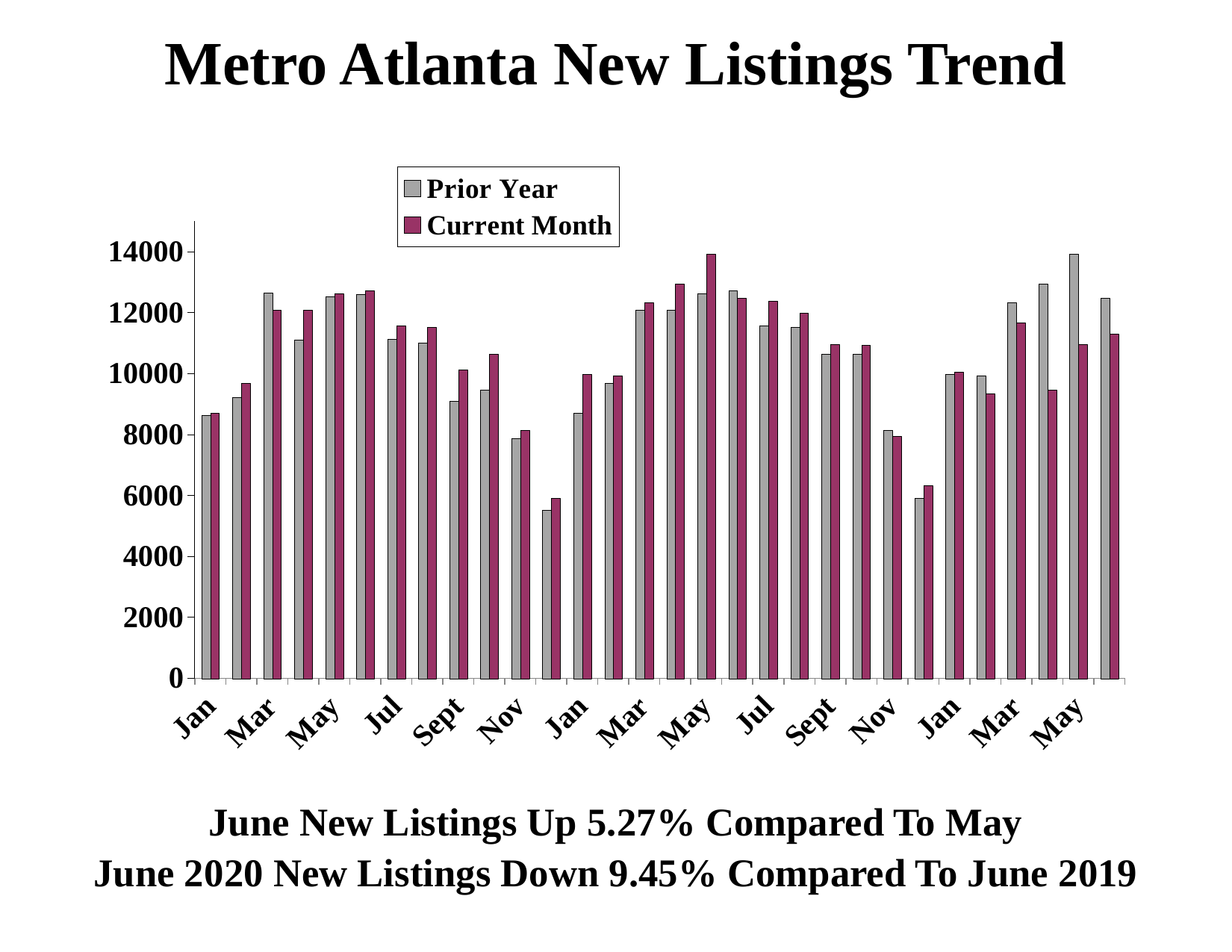
For the last May on the x axis, which is larger: the Prior Year bar or the Current Month bar? Prior Year Which month has the lowest Prior Year bar? The first Dec (the bar just after the first Nov) Is the Prior Year value for the first Jan on the x axis greater or less than 8000? greater How many month labels are printed along the x axis? 15 Is the Prior Year value for the first Sept on the x axis greater or less than 10000? less Which month has the highest Current Month bar? The second May Is the Prior Year value for the last Mar on the x axis greater or less than 12000? greater What type of chart is shown on the slide? Bar chart What are the two series named in the legend? Prior Year and Current Month What is the title of the chart? Metro Atlanta New Listings Trend How many series does the legend list? 2